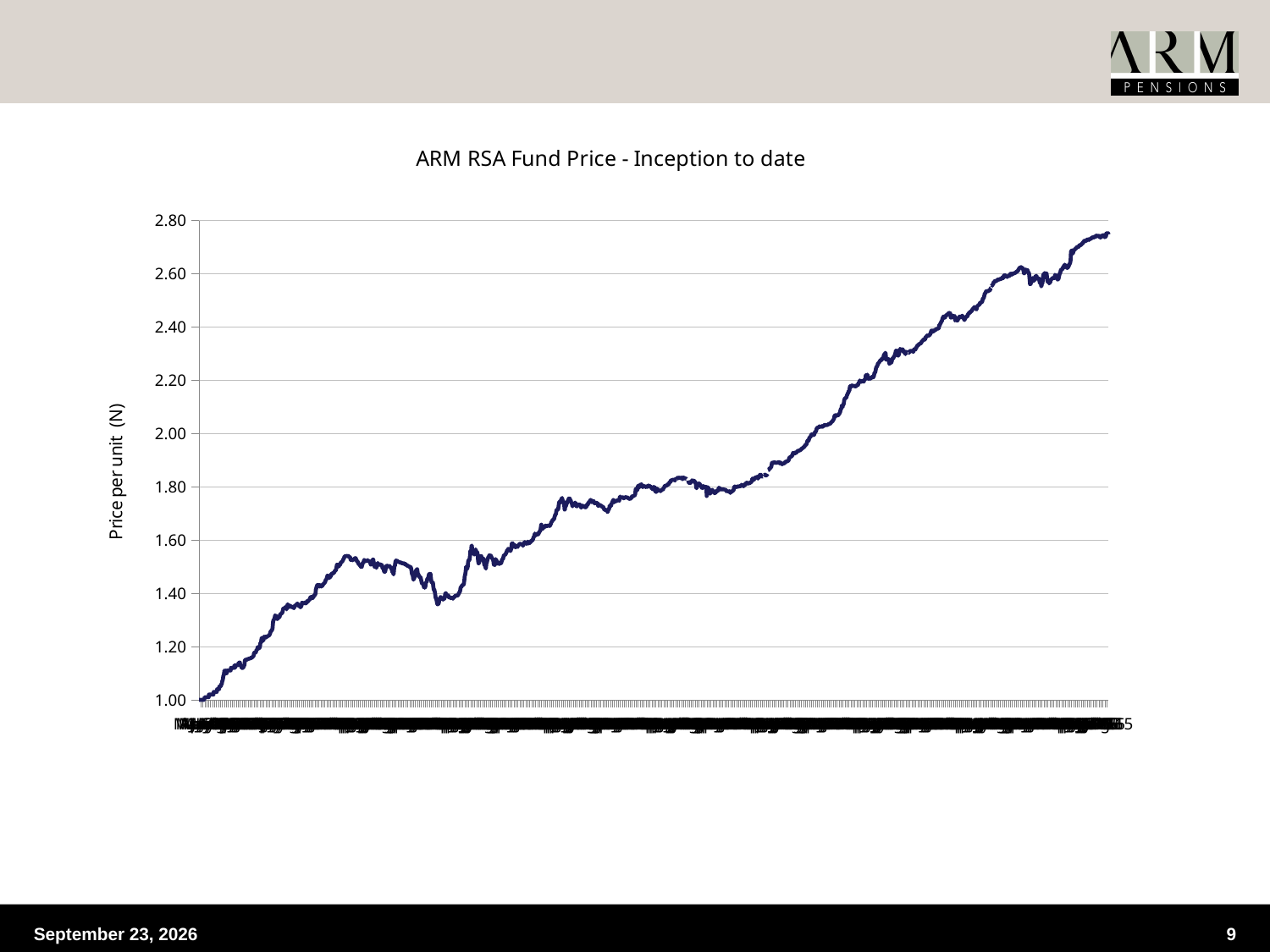
Is the value of the line at the right-hand end of the chart greater or less than 2.80? less How many lines (series) are plotted on the chart? 1 What is the highest tick value shown on the vertical axis? 2.80 Overall, does the fund price rise or fall from left to right along the x axis? rise What is the value of the line at the very start of the series (inception)? 1.00 What is the label on the vertical axis of the chart? Price per unit (N) What is the title of the chart? ARM RSA Fund Price - Inception to date Is the value at the right-hand end of the line larger or smaller than the value at the left-hand start? larger Is the value of the line at the right-hand end of the chart greater or less than 2.60? greater What kind of chart is shown on the slide? line chart Is the value of the line at the left-hand start of the chart greater or less than 1.20? less